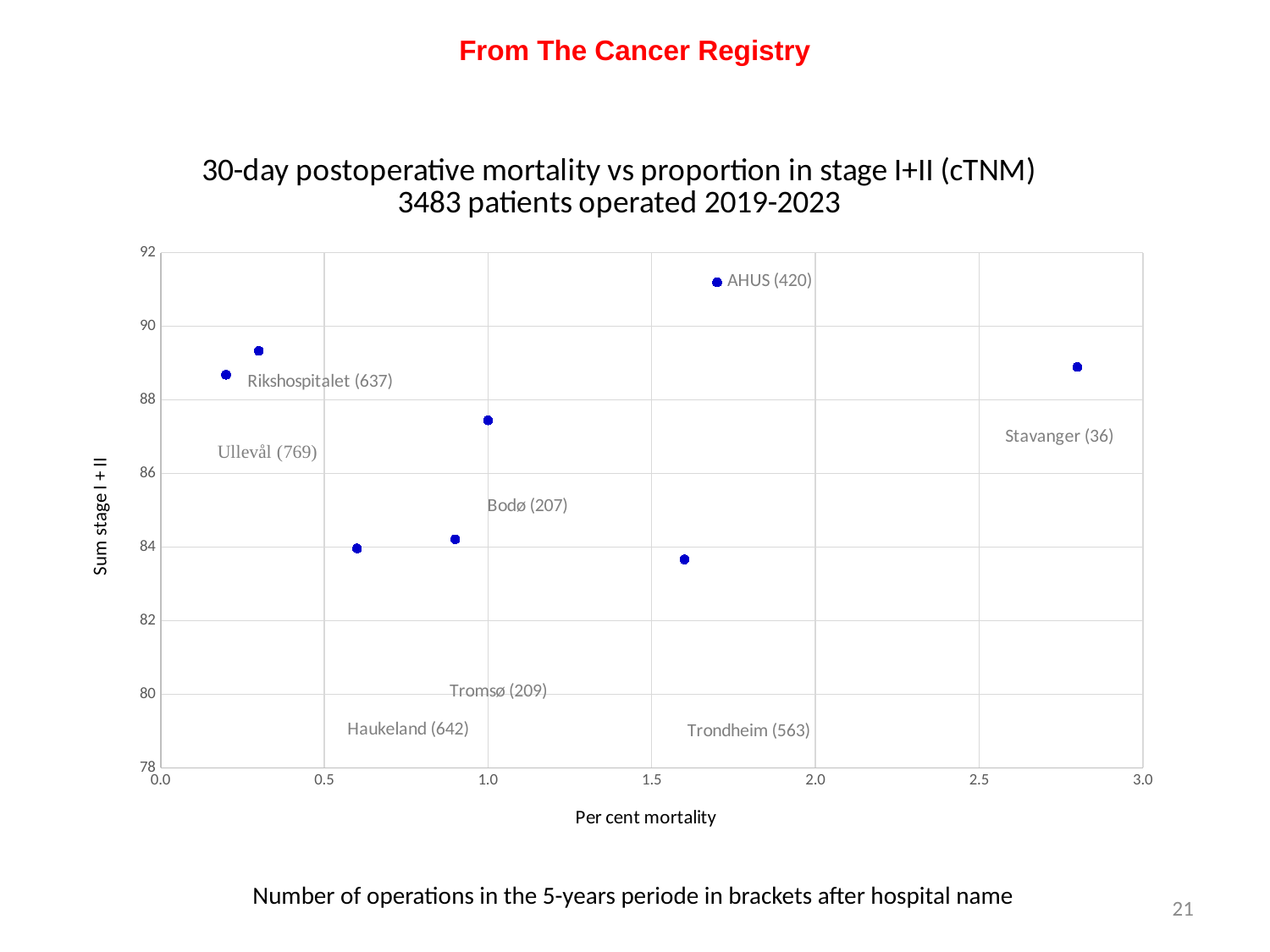
What is the label of the x axis? Per cent mortality Is the Sum stage I + II value for AHUS greater or less than 90? greater Is the per cent mortality for Stavanger greater or less than 2.5? greater How many data points are plotted on the chart? 8 Which hospital has the highest proportion in stage I+II (highest point on the y axis)? AHUS How many operations are shown in brackets for Stavanger? 36 Which hospital has the highest per cent mortality (furthest right on the x axis)? Stavanger What kind of chart is shown on the slide? scatter chart Is the Sum stage I + II value for Bodø greater or less than 86? greater Which has a higher Sum stage I + II value, Bodø or Tromsø? Bodø Which has a higher Sum stage I + II value, AHUS or Stavanger? AHUS